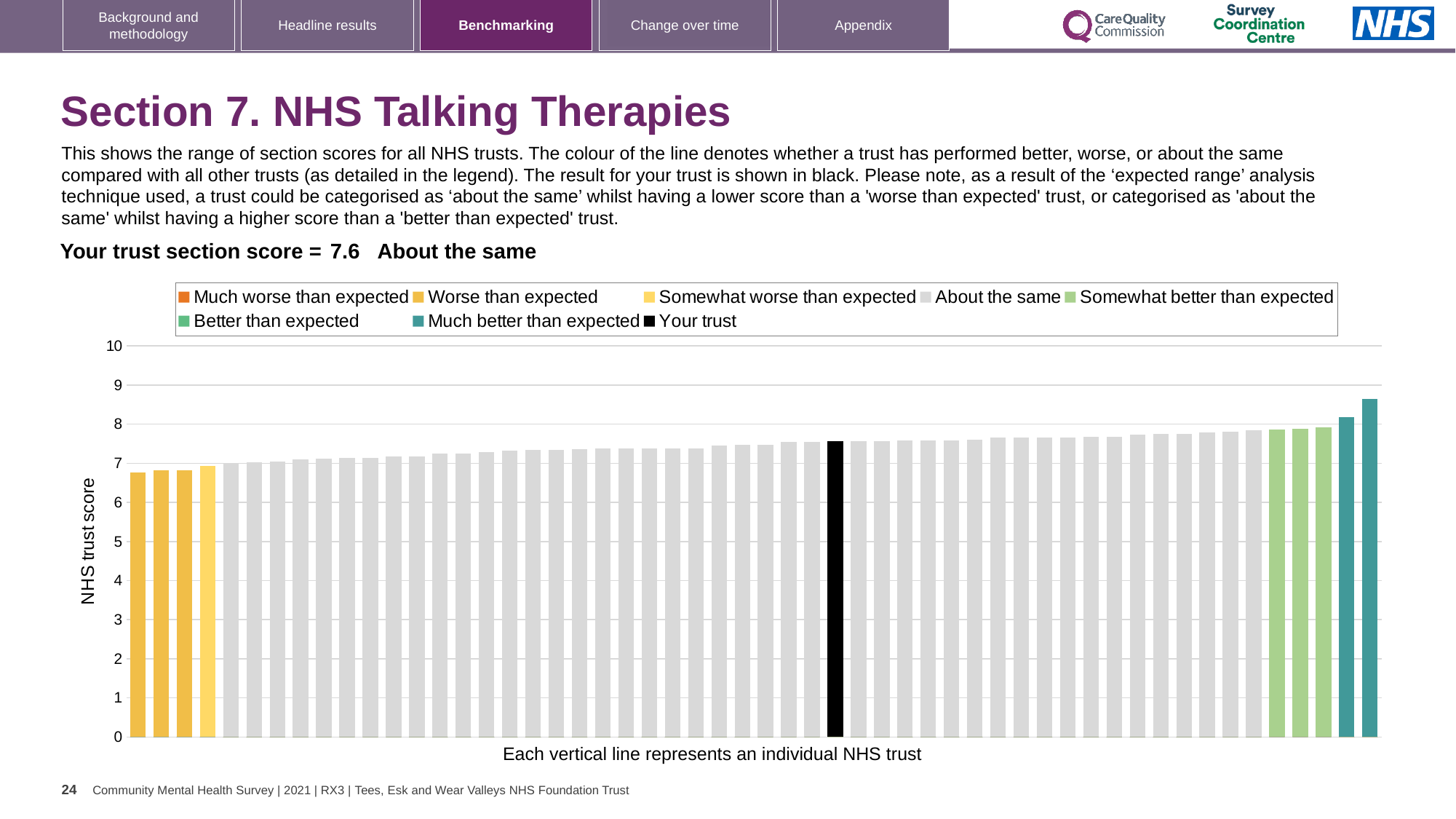
Is the value of the tallest bar greater or less than 8? greater Do the bar values rise or fall from left to right along the x axis? rise How many bars are coloured as 'Much better than expected'? 2 Which legend category does the lowest bar on the chart belong to? Worse than expected What is the label on the vertical axis of the chart? NHS trust score Which legend category does the highest bar on the chart belong to? Much better than expected How many entries does the chart legend list? 8 What is the section score for your trust shown on the chart? 7.6 What kind of chart is shown on the slide? bar chart Which category is your trust placed in according to the slide? About the same Is the value of the shortest bar greater or less than 7? less Is the value for your trust greater or less than 7? greater